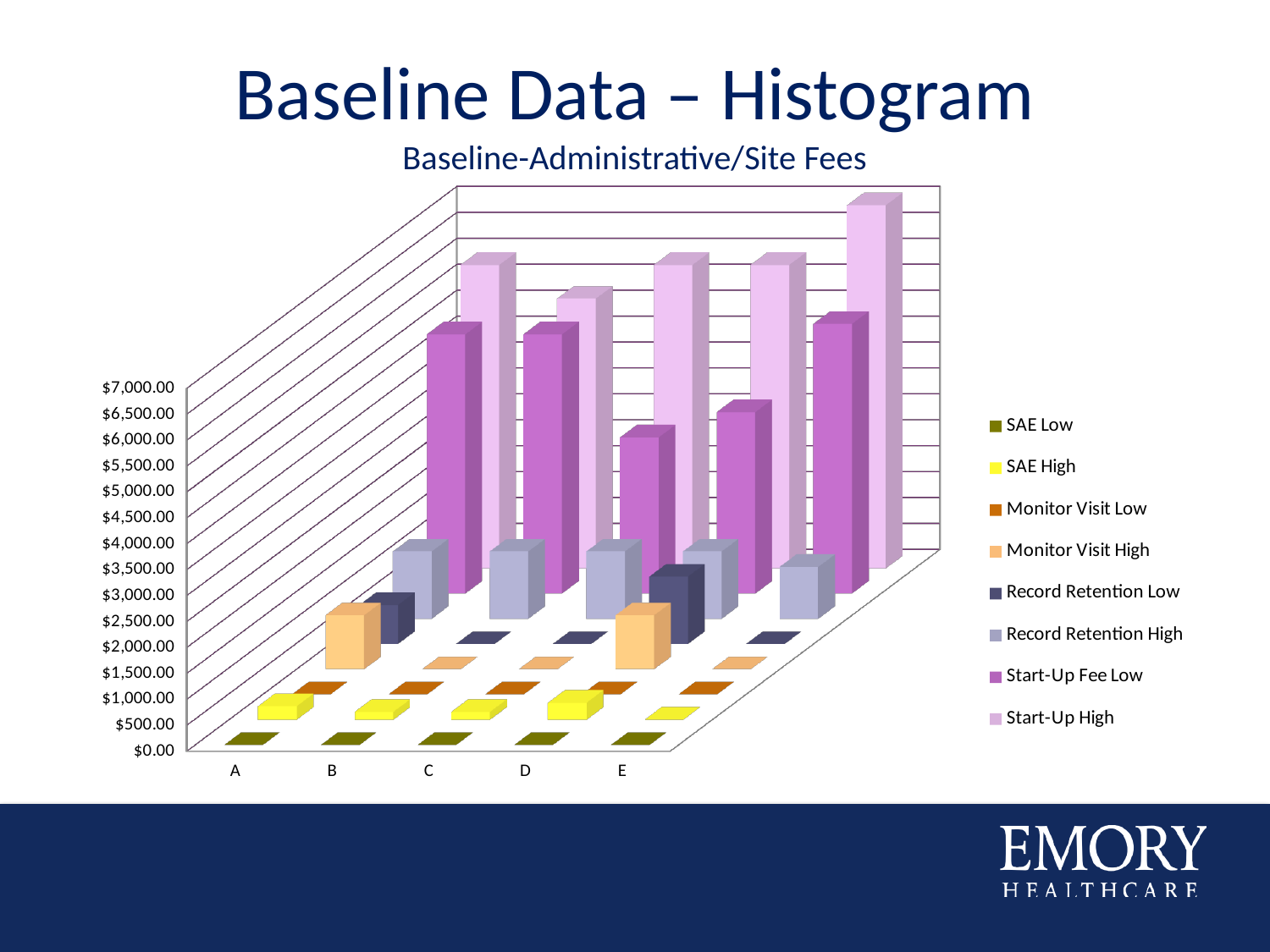
What is the title of the chart? Baseline-Administrative/Site Fees Which is larger, the Start-Up High value for E or the Start-Up High value for B? E What kind of chart is shown on the slide? bar chart How many series does the legend list? 8 How many categories are shown on the x axis? 5 Which legend entry is listed last? Start-Up High Is the Start-Up High value for E greater or less than $5,000.00? greater Which category has the highest Start-Up High value? E Is the Monitor Visit Low value for C greater or less than $1,000.00? less Is the SAE Low value for A greater or less than $1,000.00? less